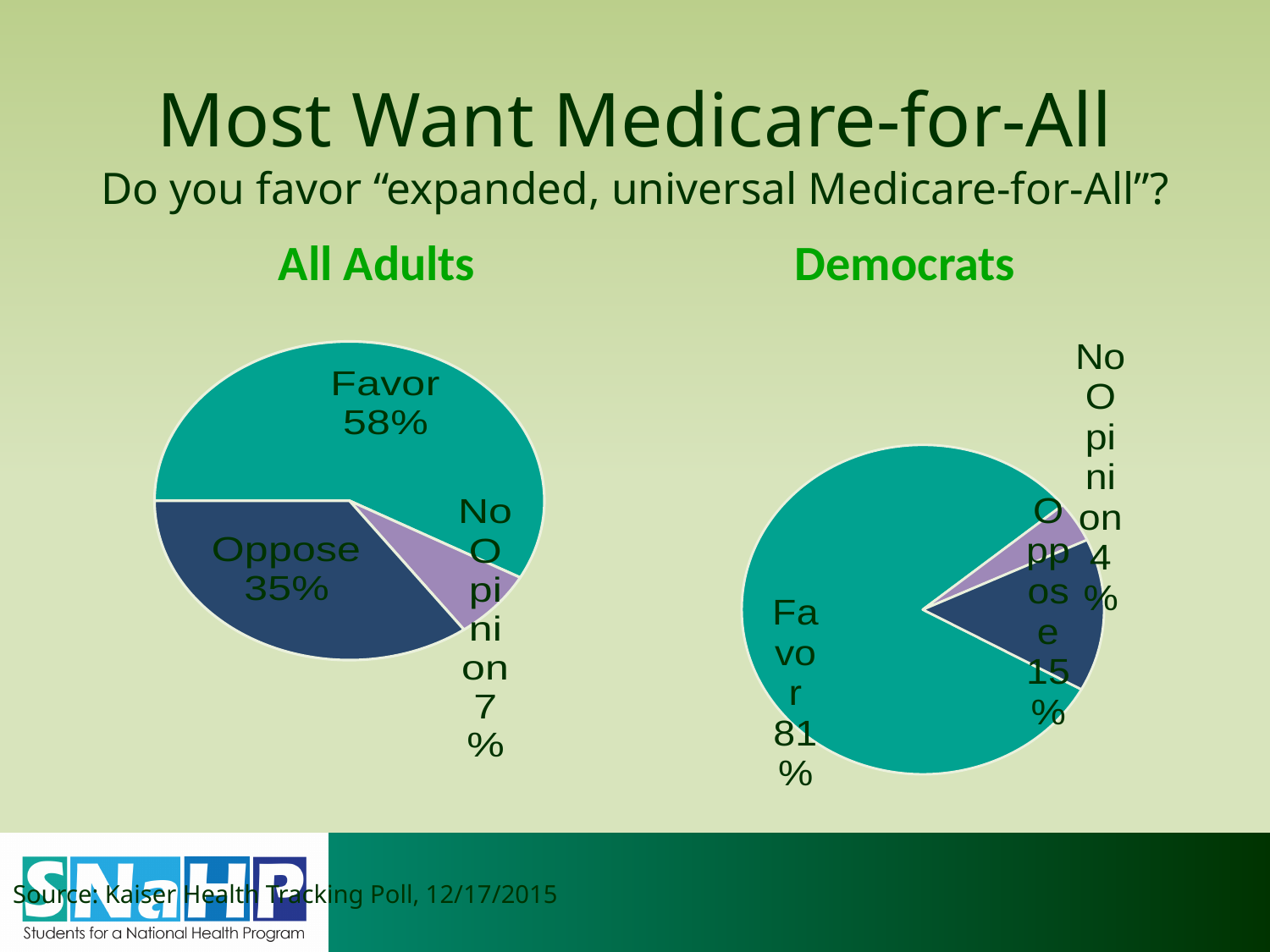
In the All Adults chart, which response has the largest slice? Favor What type of chart is used for the All Adults data? Pie chart In the Democrats chart, which response has the smallest slice? No Opinion In the All Adults chart, what is the difference between the Favor and Oppose percentages? 23% In the All Adults chart, what percentage of respondents favor Medicare-for-All? 58% In the All Adults chart, what percentage oppose Medicare-for-All? 35% Is the Favor percentage larger in the All Adults chart or the Democrats chart? Democrats How many slices does the Democrats pie chart have? 3 In the Democrats chart, what percentage oppose Medicare-for-All? 15% In the Democrats chart, what percentage have no opinion? 4% In the Democrats chart, what percentage favor Medicare-for-All? 81% In the All Adults chart, what percentage have no opinion? 7%